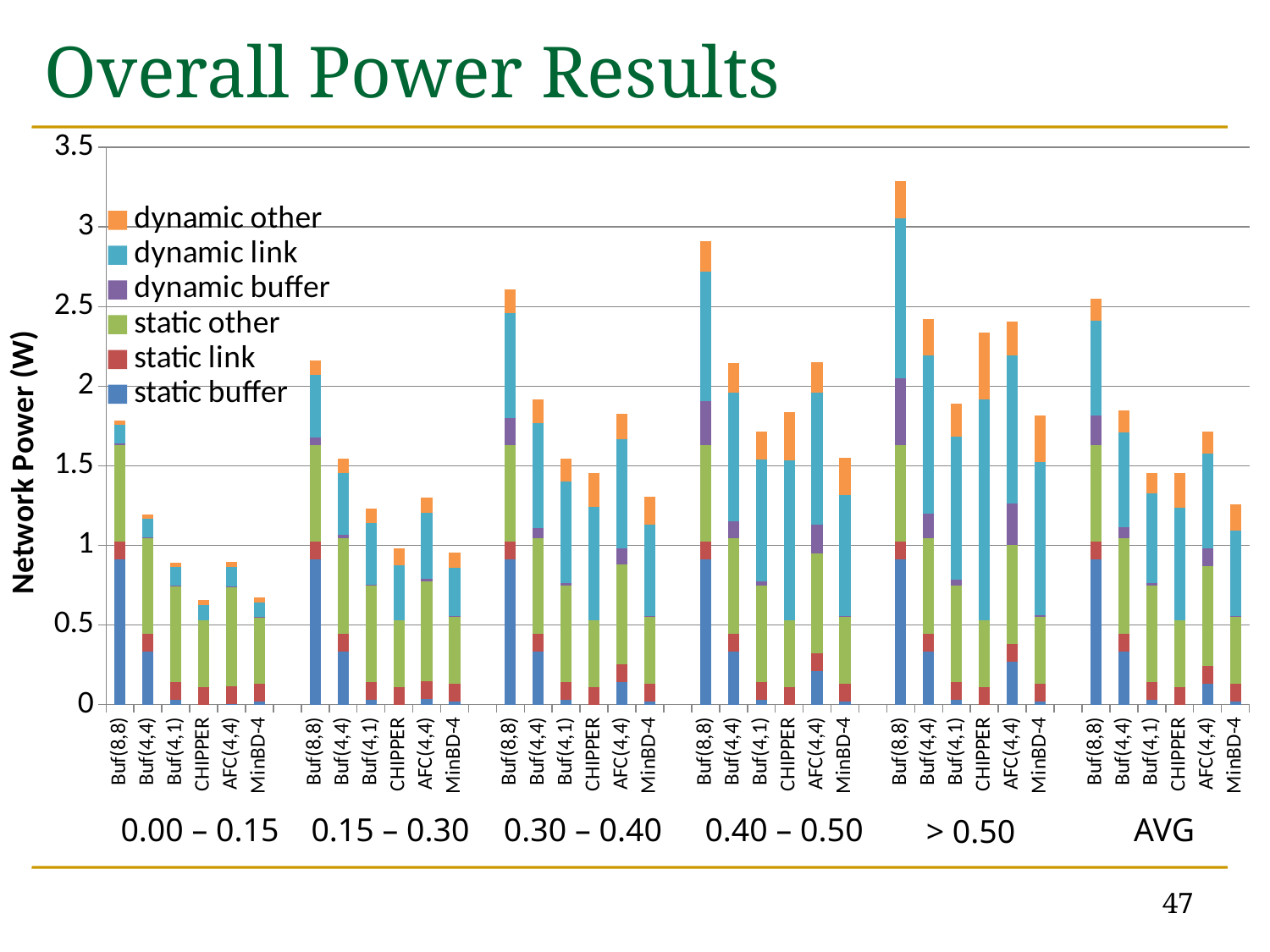
Is the total for MinBD-4 in the AVG group greater or less than 1? greater How many traffic-range groups are shown along the x axis? 6 What is the label of the y axis? Network Power (W) Which bar has the highest total network power on the chart? Buf(8,8) in the > 0.50 group Which bar has the lowest total network power on the chart? CHIPPER in the 0.00 – 0.15 group Is the total for Buf(8,8) in the 0.00 – 0.15 group greater or less than 2? less How many bars are plotted in the AVG group? 6 In the AVG group, which has the larger total: Buf(8,8) or MinBD-4? Buf(8,8) In the 0.00 – 0.15 group, which has the larger total: Buf(4,4) or CHIPPER? Buf(4,4) Is the total for Buf(8,8) in the > 0.50 group greater or less than 3? greater What kind of chart is shown on the slide? Stacked bar chart How many series does the legend list? 6